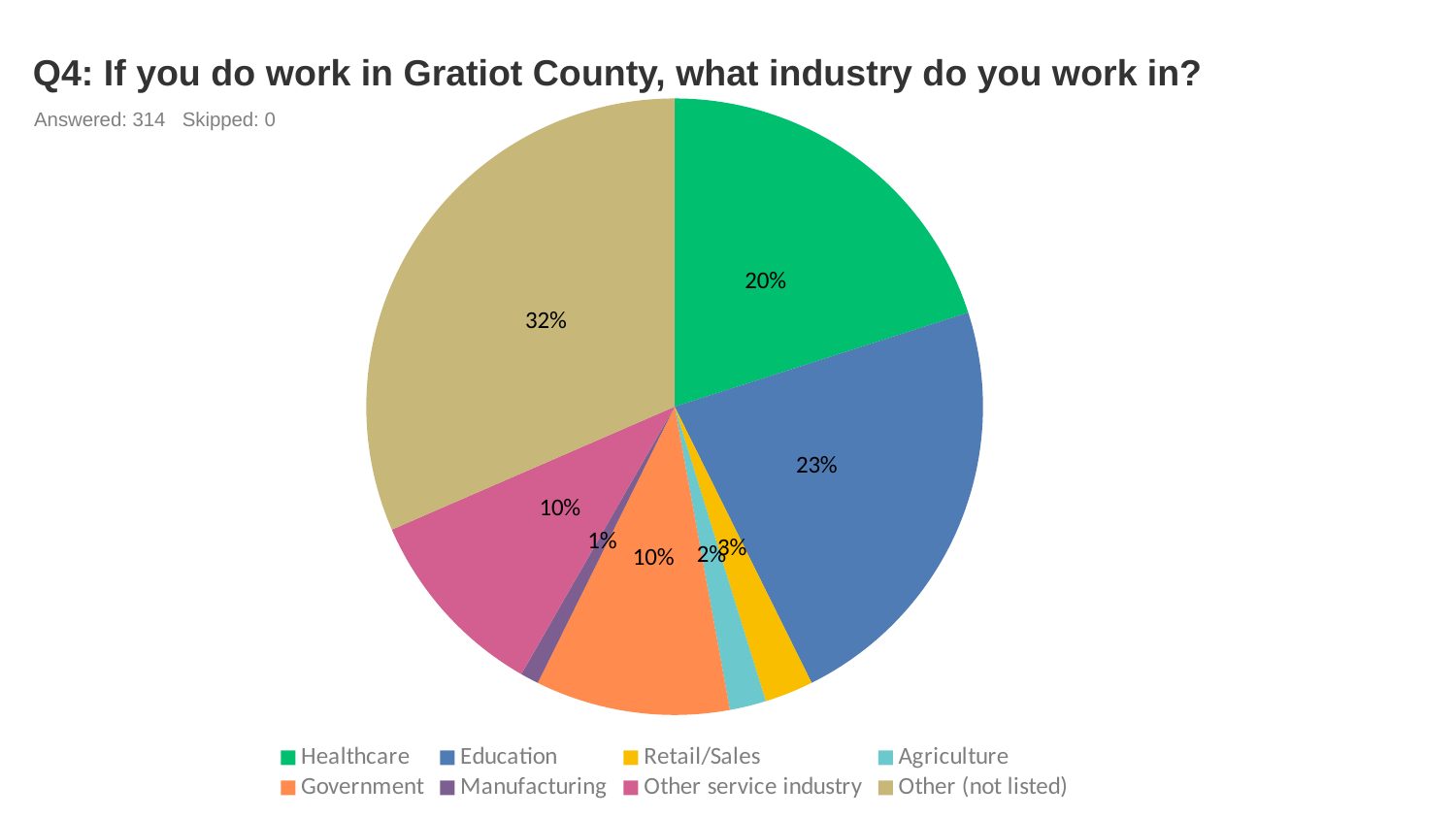
How many industry categories does the legend list? 8 How many respondents answered this question according to the slide? 314 Which industry has the smallest slice of the pie? Manufacturing What share of the pie does Manufacturing represent? 1% Which industry has the largest slice of the pie? Other (not listed) What share of the pie does Other (not listed) represent? 32% Which is larger, the Education slice or the Healthcare slice? Education What share of the pie does Education represent? 23% What kind of chart is shown on the slide? pie chart What is the difference in percentage points between Other (not listed) and Education? 9